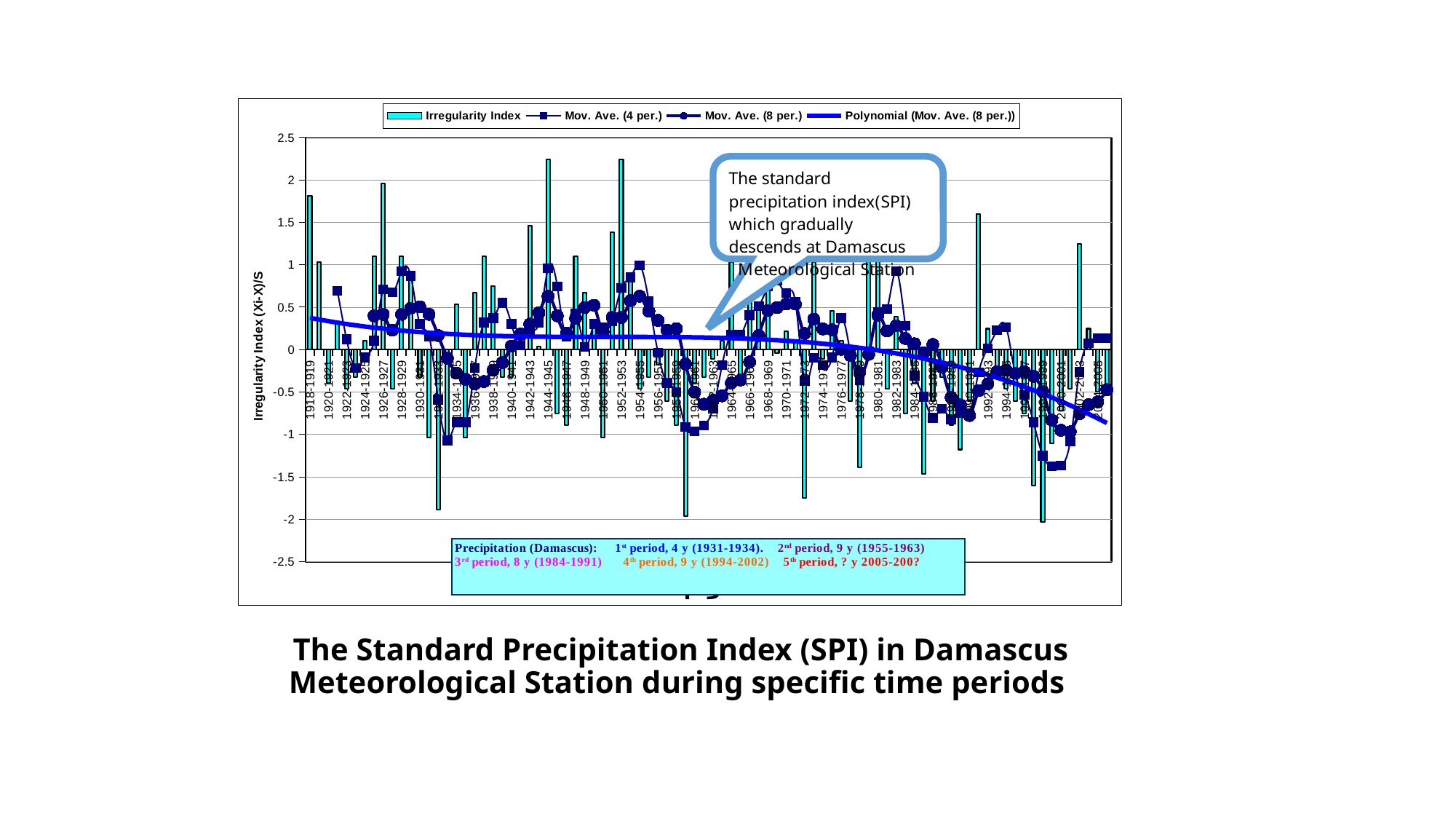
Which series is drawn as cyan bars according to the legend? Irregularity Index Is the Irregularity Index bar for 1926-1927 greater or less than 1.5? greater Is the Irregularity Index bar for 1944-1945 greater or less than 2? greater Which has the larger Irregularity Index bar, 1944-1945 or 1918-1919? 1944-1945 Is the Irregularity Index bar for 1960-1961 greater or less than -1.5? greater What is the label of the vertical axis? Irregularity Index (Xi-X)/S What is the highest value shown on the vertical axis? 2.5 Does the thick Polynomial (Mov. Ave. (8 per.)) line rise or fall from left to right along the x axis? Fall What kind of chart is this? Combined bar and line chart How many series does the legend list? 4